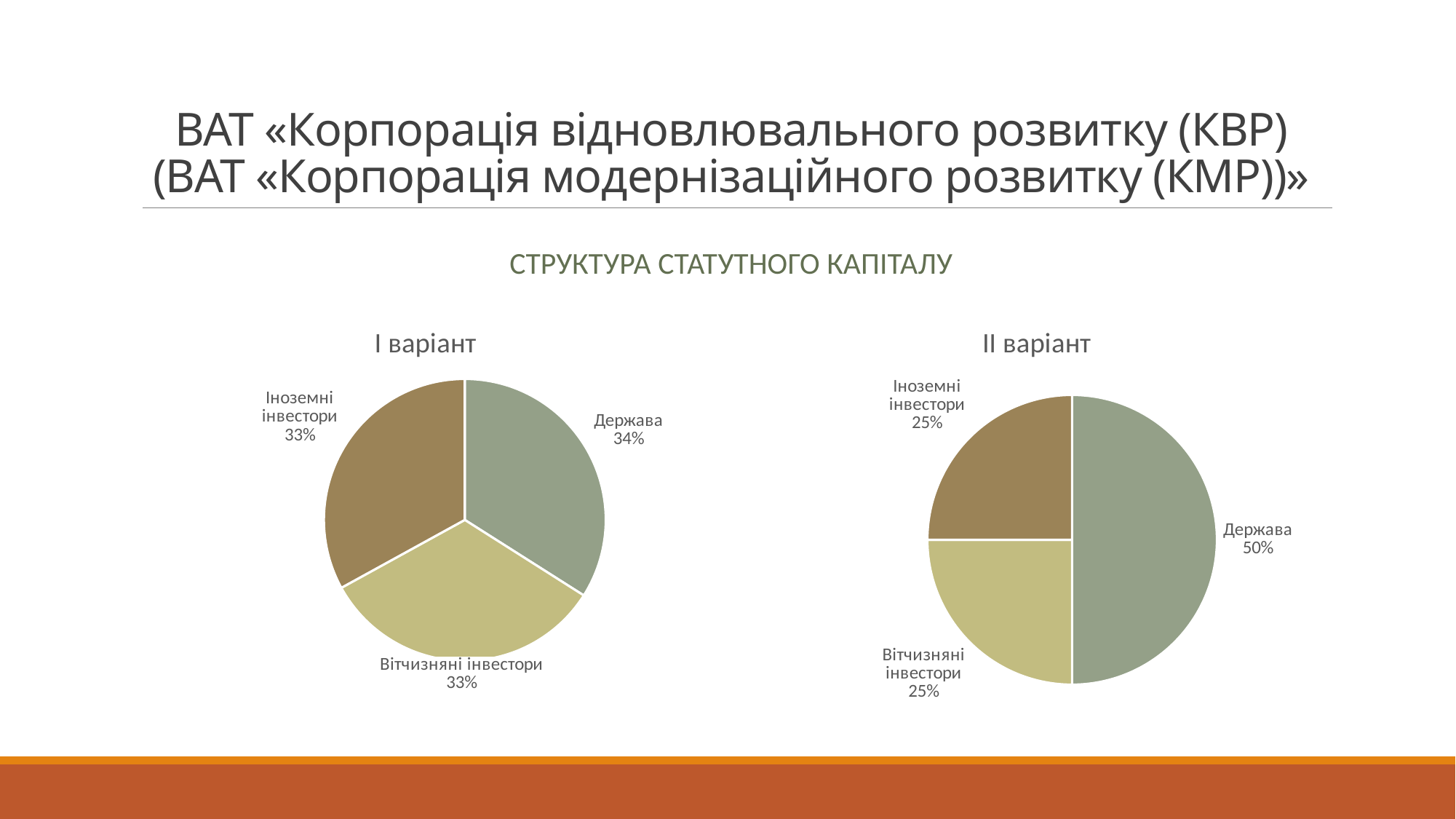
What is the title of the "I варіант" chart? I варіант In the "II варіант" chart, what share do Вітчизняні інвестори have? 25% In the "II варіант" chart, what is the difference between the Держава share and the Іноземні інвестори share? 25% What kind of chart is the "II варіант" chart? Pie chart In the "I варіант" chart, what share do Іноземні інвестори have? 33% In the "I варіант" chart, what share does Держава have? 34% What is the heading shown above the two charts? СТРУКТУРА СТАТУТНОГО КАПІТАЛУ Which is larger: the Держава share in the "I варіант" chart or the Держава share in the "II варіант" chart? II варіант In the "II варіант" chart, what share does Держава have? 50% In the "II варіант" chart, which category has the largest slice? Держава How many slices does the "I варіант" chart have? 3 In the "I варіант" chart, which category has the largest slice? Держава